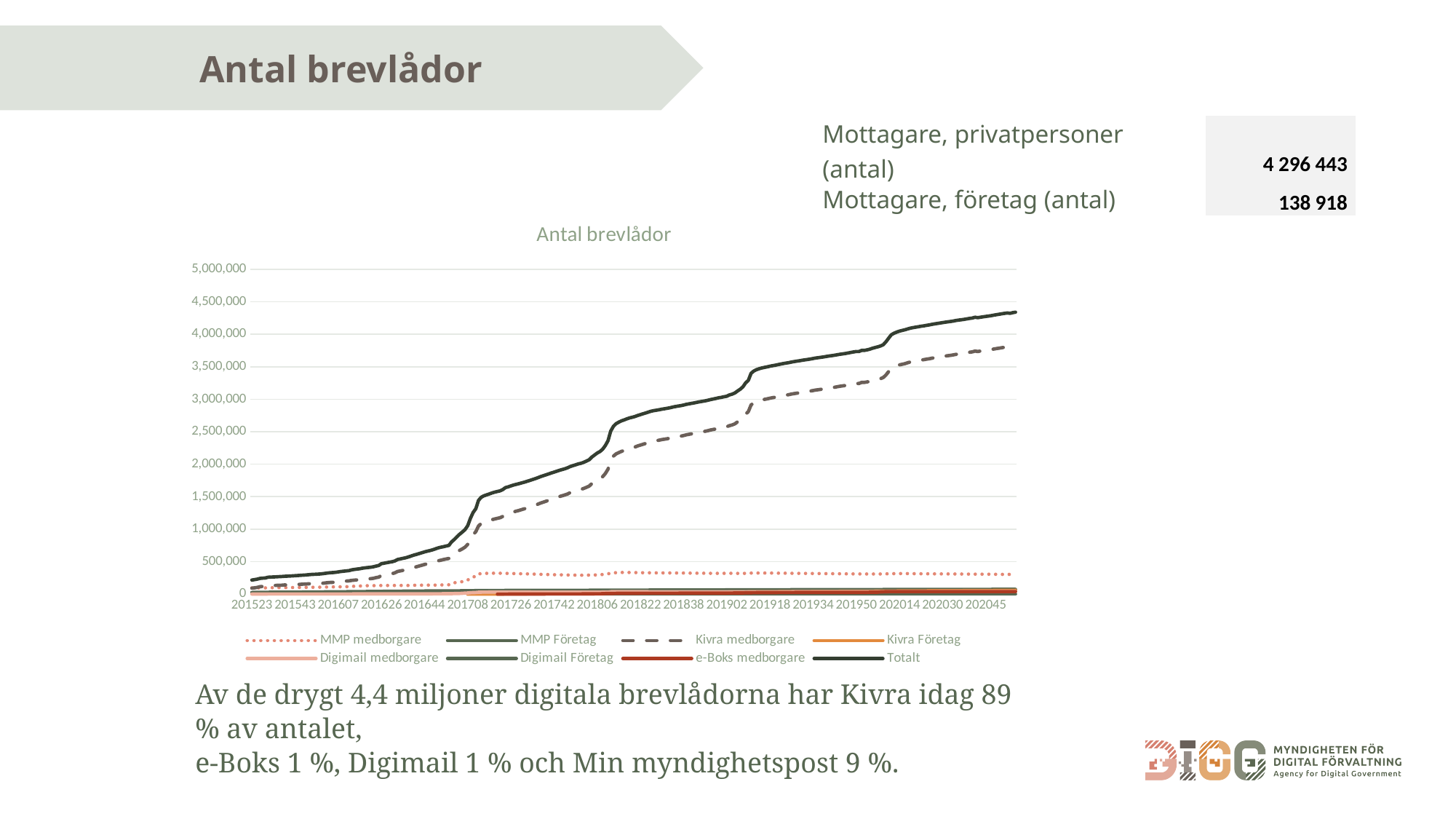
Which series reaches the highest value in the chart? Totalt What is the title of the chart? Antal brevlådor Is the value of the Totalt series at 201822 greater or less than 2,500,000? greater How many series does the legend of the chart list? 8 Does the Totalt series rise or fall from 201523 to 202045? rise Is the value of the Totalt series at 202045 greater or less than 4,000,000? greater At 202045, which series has the higher value: Totalt or Kivra medborgare? Totalt Is the value of the MMP medborgare series at 202045 greater or less than 500,000? less Which series in the chart is drawn with a dotted line? MMP medborgare What kind of chart is shown on the slide? line chart